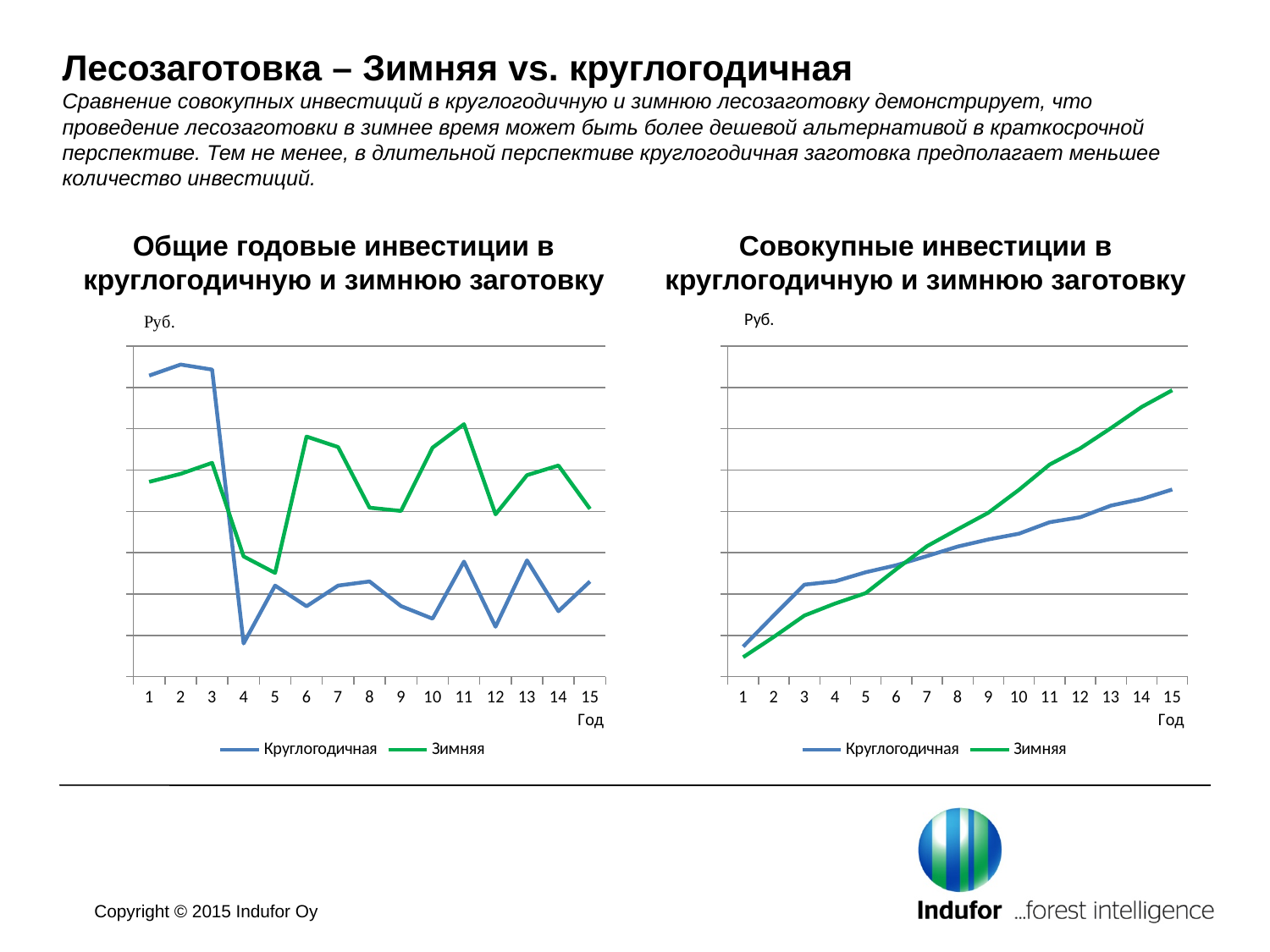
In the left chart, 'Общие годовые инвестиции', in which year is the Круглогодичная series at its lowest? 4 In the left chart, 'Общие годовые инвестиции', which series is higher at year 10, Круглогодичная or Зимняя? Зимняя What unit label is shown on the y axis of the right chart? Руб. In the right chart, 'Совокупные инвестиции', does the Зимняя series rise or fall from year 1 to year 15? Rises How many years are plotted along the x axis of the right chart? 15 What kind of chart is the right chart, 'Совокупные инвестиции в круглогодичную и зимнюю заготовку'? Line chart In the right chart, 'Совокупные инвестиции', which series is higher at year 3, Круглогодичная or Зимняя? Круглогодичная How many series does the legend of the left chart list? 2 In the right chart, 'Совокупные инвестиции', which series is higher at year 15, Круглогодичная or Зимняя? Зимняя In the left chart, 'Общие годовые инвестиции', in which year is the Зимняя series at its lowest? 5 What kind of chart is the left chart, 'Общие годовые инвестиции в круглогодичную и зимнюю заготовку'? Line chart In the left chart, 'Общие годовые инвестиции', in which year is the Круглогодичная series at its highest? 2